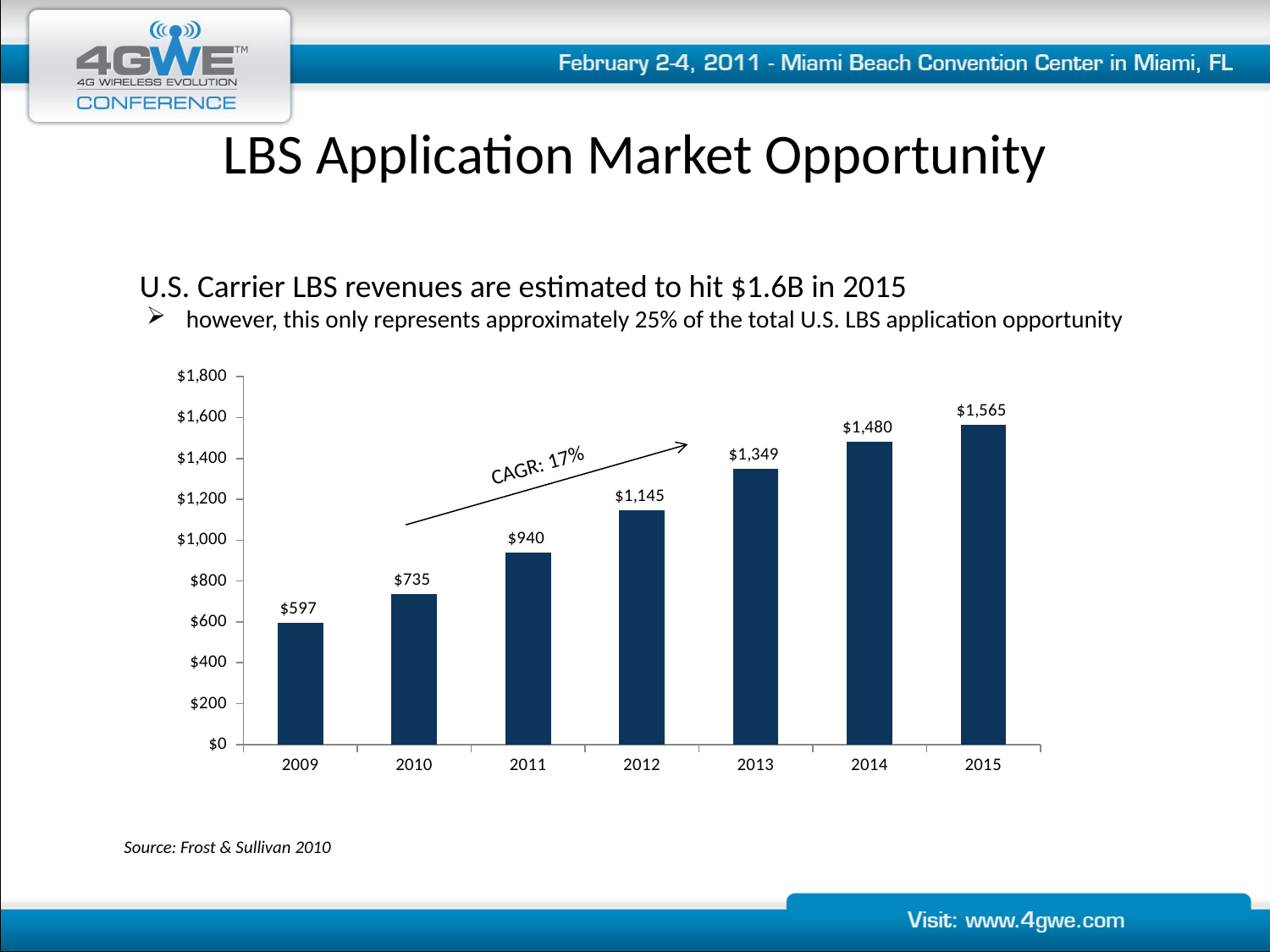
What is the difference between the values for 2015 and 2009? $968 What kind of chart is shown on the slide? bar chart How many years are shown on the x axis? 7 What is the value for 2015? $1,565 Do the values rise or fall from 2009 to 2015? rise Which is larger, the value for 2011 or the value for 2010? 2011 What is the value for 2012? $1,145 Which year has the lowest value? 2009 What is the value for 2009? $597 Is the value for 2013 greater or less than $1,200? greater What is the difference between the values for 2014 and 2013? $131 Which year has the highest value? 2015